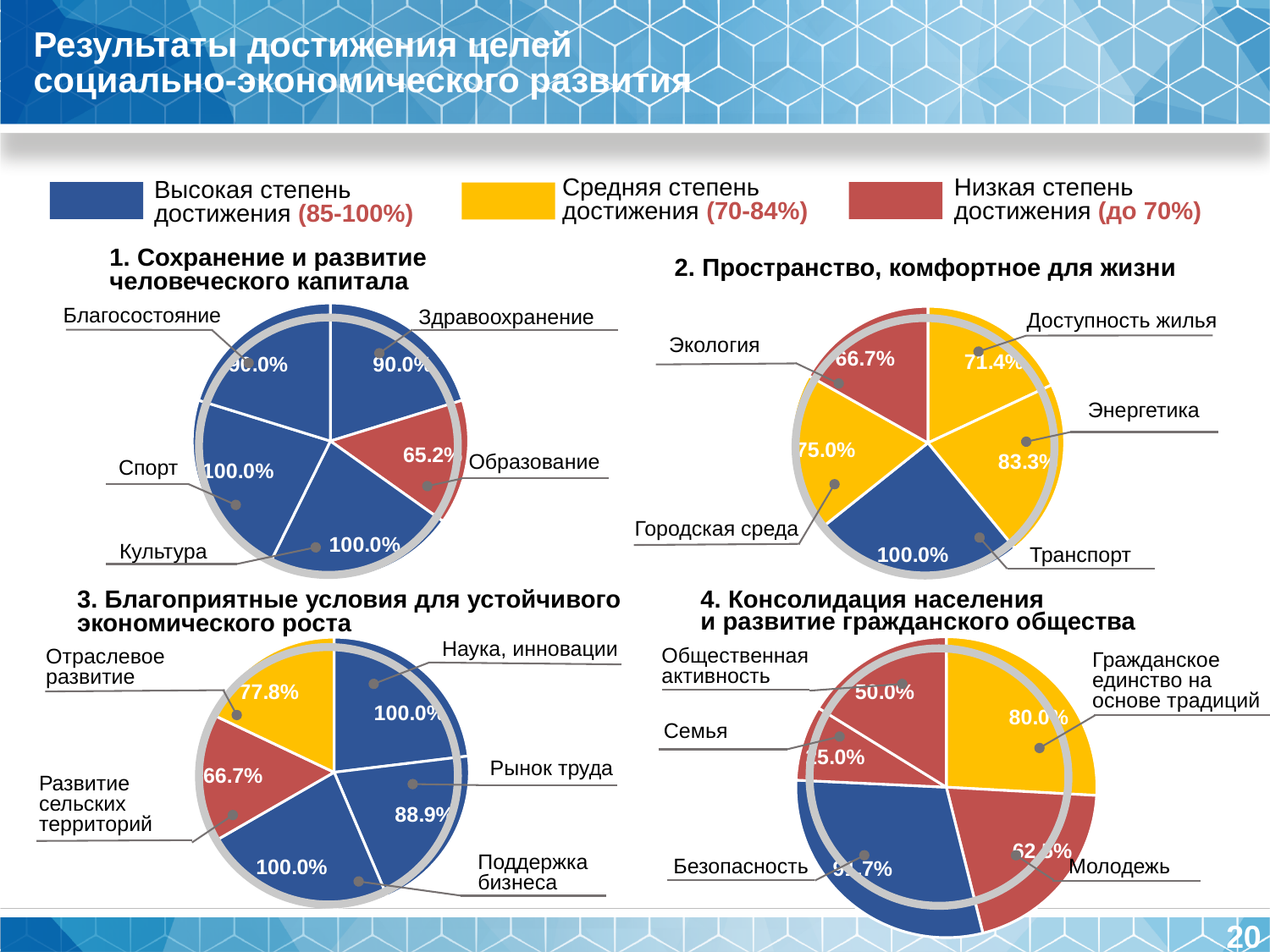
On the chart '3. Благоприятные условия для устойчивого экономического роста', what is the value for Рынок труда? 88.9% On the chart '4. Консолидация населения и развитие гражданского общества', what is the value for Общественная активность? 50.0% On the chart '2. Пространство, комфортное для жизни', what is the value for Энергетика? 83.3% On the chart '2. Пространство, комфортное для жизни', which category has the highest value? Транспорт On the chart '2. Пространство, комфортное для жизни', what is the difference between the values for Транспорт and Экология? 33.3% On the chart '1. Сохранение и развитие человеческого капитала', which category has the lowest value? Образование What kind of chart is used for '4. Консолидация населения и развитие гражданского общества'? Pie chart On the chart '1. Сохранение и развитие человеческого капитала', what is the value for Образование? 65.2% On the chart '2. Пространство, комфортное для жизни', which is larger: the value for Доступность жилья or the value for Городская среда? Городская среда On the chart '3. Благоприятные условия для устойчивого экономического роста', what is the value for Отраслевое развитие? 77.8% On the chart '3. Благоприятные условия для устойчивого экономического роста', how many categories are shown? 5 On the chart '1. Сохранение и развитие человеческого капитала', what is the value for Здравоохранение? 90.0%